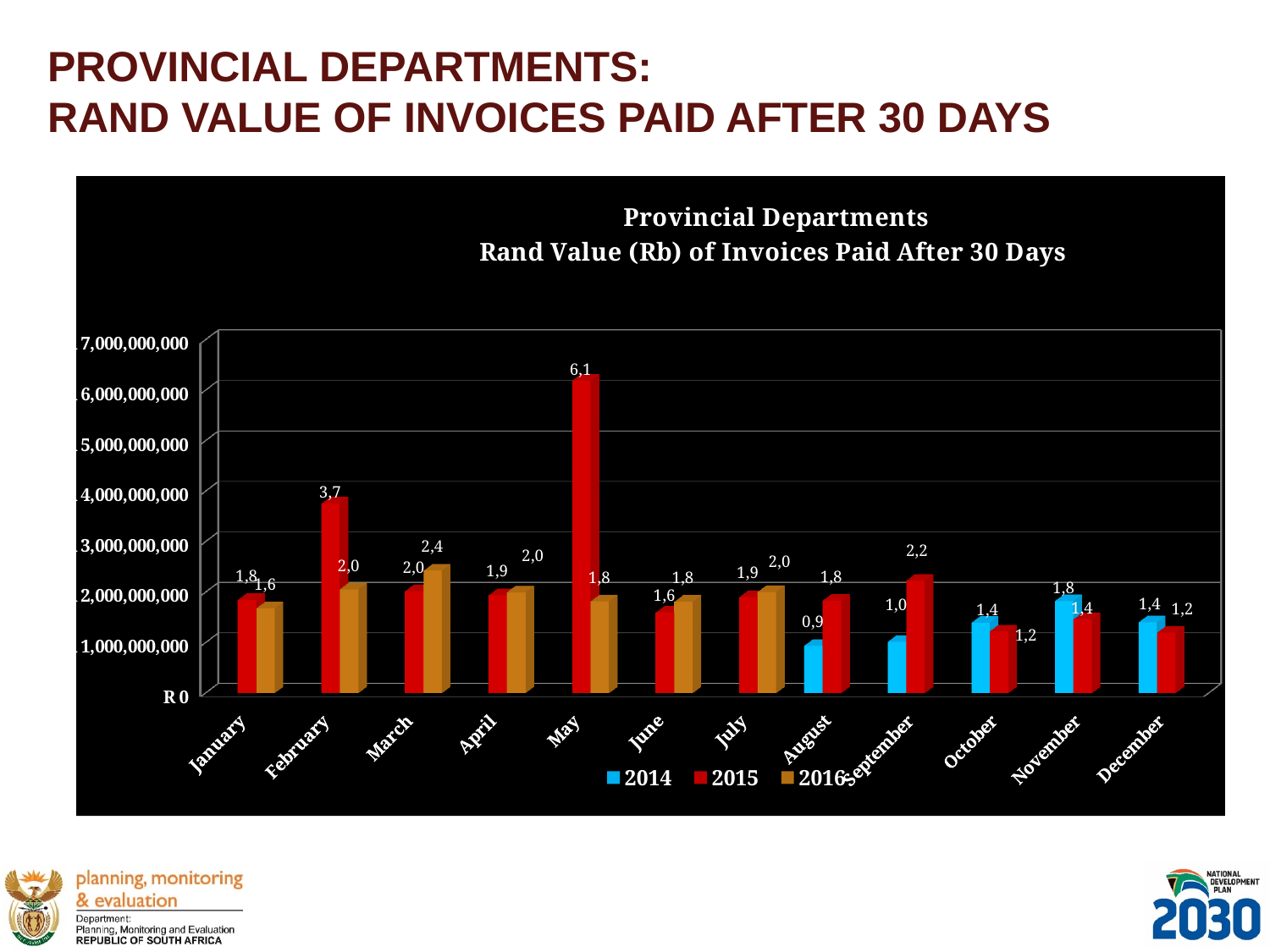
How many series does the legend list? 3 What is the difference between the 2015 and 2016 values in February? 1,7 Which month has the lowest value for the 2014 series? August Which month has the highest value for the 2015 series? May What is the value for 2014 in September? 1,0 How many months are shown on the x axis? 12 What kind of chart is shown on the slide? bar chart What is the value for 2015 in May? 6,1 In October, which series has the larger value, 2014 or 2015? 2014 What colour represents the 2015 series in the legend? red What is the value for 2016 in March? 2,4 Is the 2015 value for May greater or less than 5,000,000,000 on the axis? greater